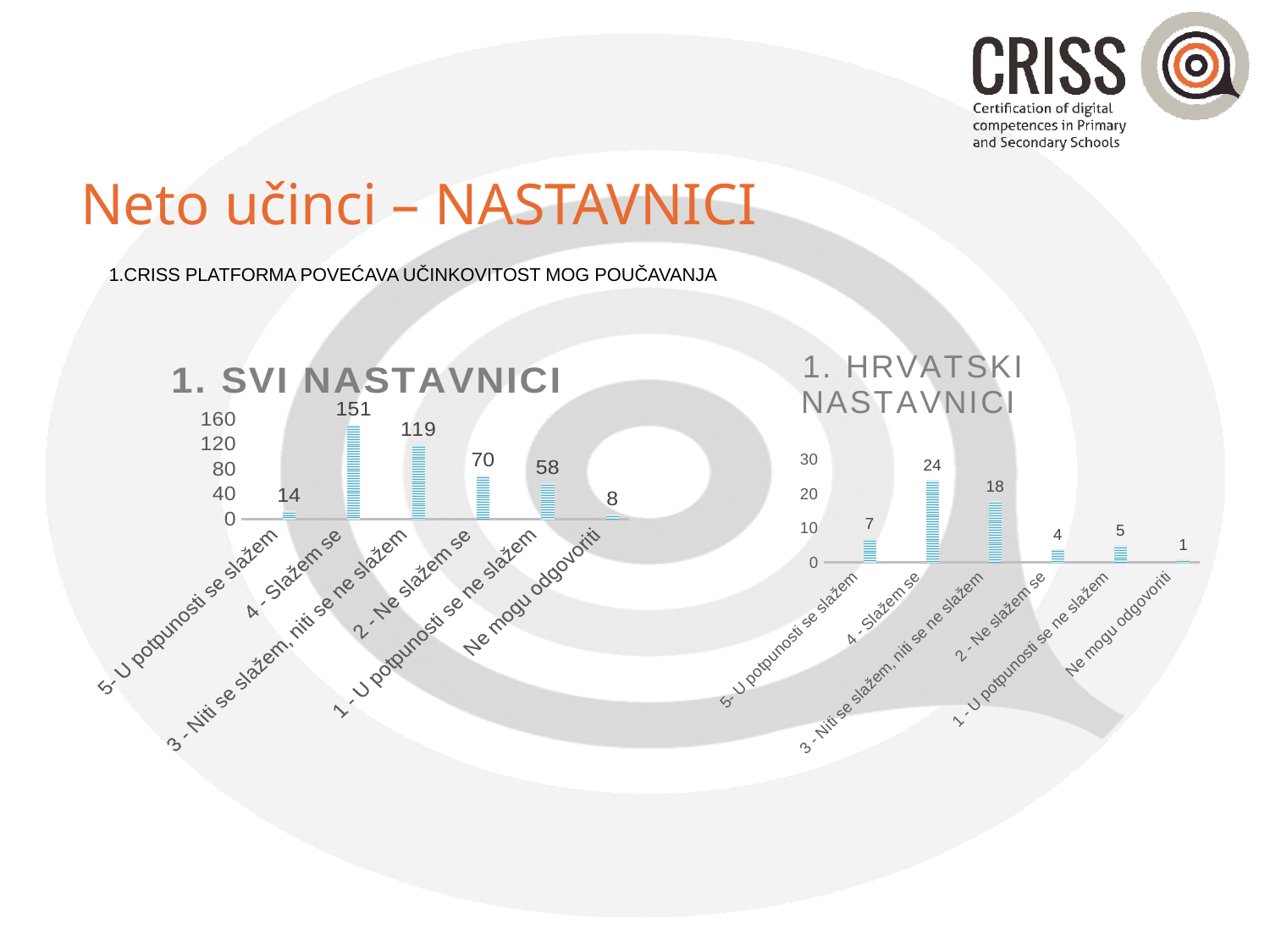
In the chart titled "1. HRVATSKI NASTAVNICI", what is the difference between the values for "4 - Slažem se" and "3 - Niti se slažem, niti se ne slažem"? 6 What is the title of the chart on the left side of the slide? 1. SVI NASTAVNICI In the chart titled "1. SVI NASTAVNICI", what is the value for "4 - Slažem se"? 151 In the chart titled "1. SVI NASTAVNICI", which category has the lowest value? Ne mogu odgovoriti In the chart titled "1. SVI NASTAVNICI", what is the value for "2 - Ne slažem se"? 70 In the chart titled "1. SVI NASTAVNICI", how many categories are shown on the x axis? 6 In the chart titled "1. HRVATSKI NASTAVNICI", what is the value for "Ne mogu odgovoriti"? 1 In the chart titled "1. HRVATSKI NASTAVNICI", what is the value for "4 - Slažem se"? 24 In the chart titled "1. SVI NASTAVNICI", what kind of chart is it? Bar chart In the chart titled "1. SVI NASTAVNICI", what is the difference between the values for "4 - Slažem se" and "3 - Niti se slažem, niti se ne slažem"? 32 In the chart titled "1. HRVATSKI NASTAVNICI", which is larger: the value for "5 - U potpunosti se slažem" or the value for "2 - Ne slažem se"? 5 - U potpunosti se slažem In the chart titled "1. HRVATSKI NASTAVNICI", which category has the highest value? 4 - Slažem se